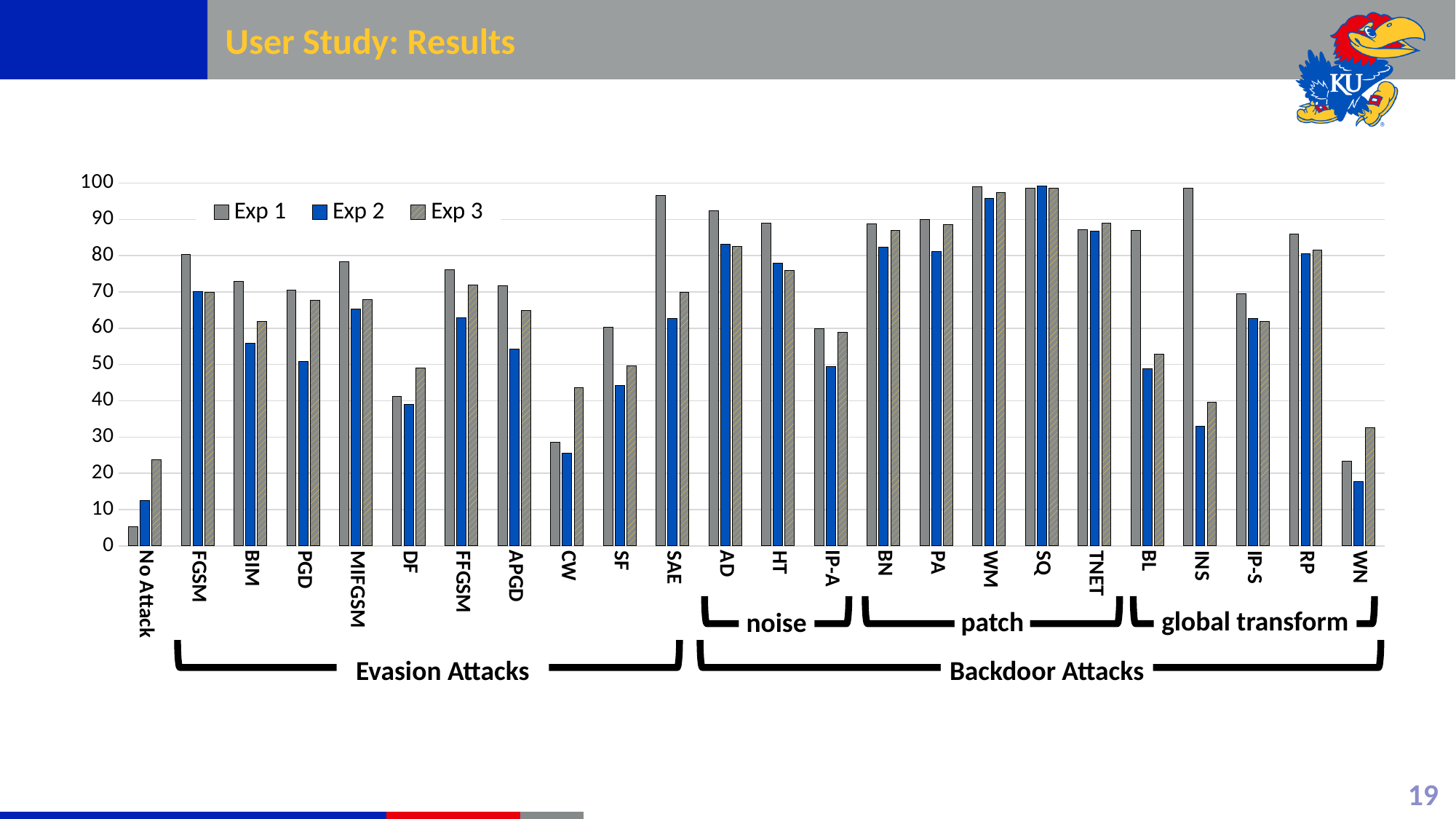
How many attack categories are shown along the x axis? 24 Is the Exp 1 value for BIM greater or less than 70? greater Which category has the lowest Exp 1 value? No Attack For INS, which is larger: the Exp 1 value or the Exp 2 value? Exp 1 What kind of chart is shown on the slide? bar chart For CW, which is larger: the Exp 1 value or the Exp 3 value? Exp 3 Is the Exp 2 value for CW greater or less than 30? less What are the three group labels shown under the Backdoor Attacks bracket? noise, patch, global transform Which category has the lowest Exp 2 value? No Attack Is the Exp 2 value for HT greater or less than 70? greater How many series does the legend list? 3